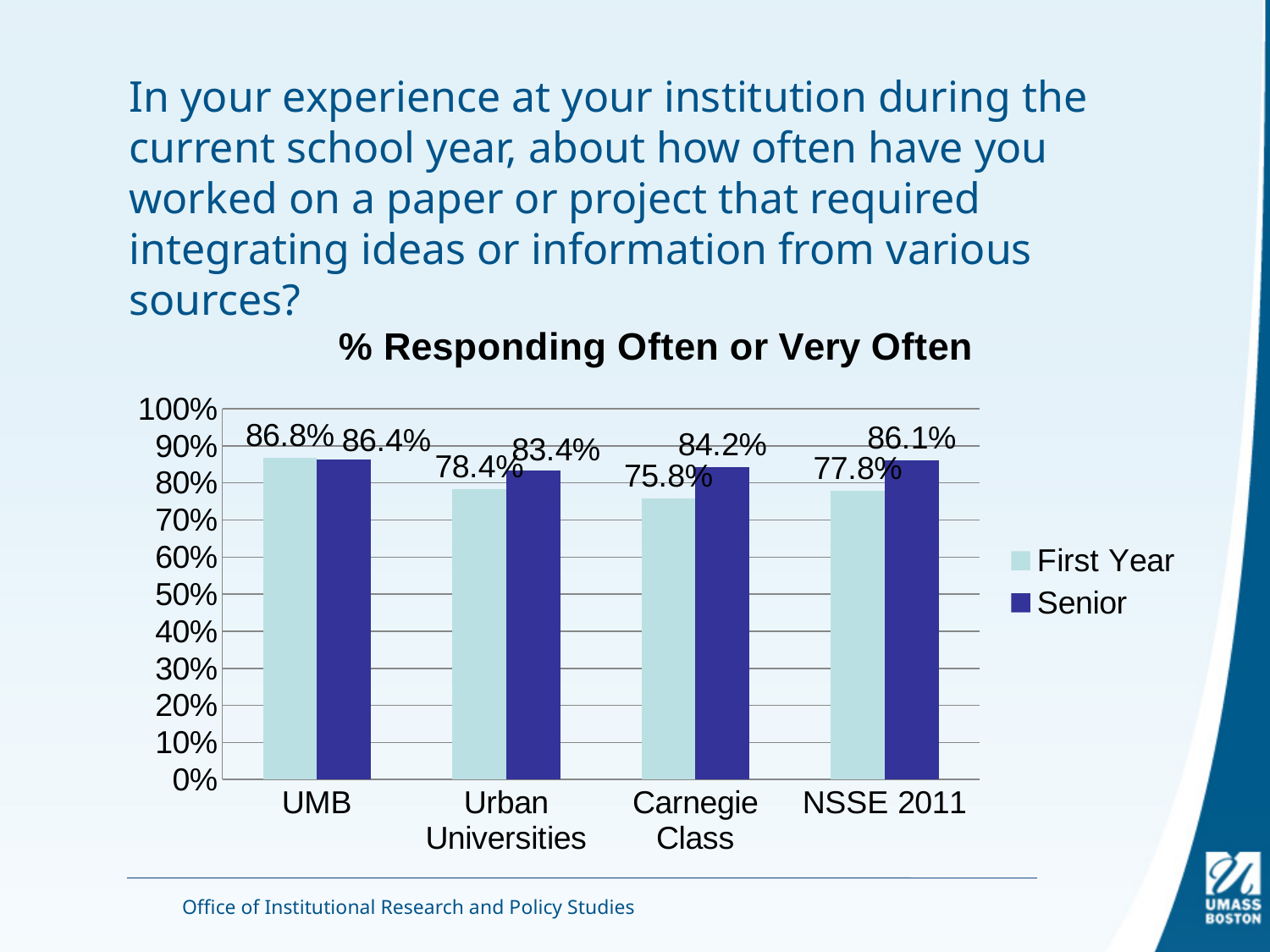
What is the Senior value for Carnegie Class? 84.2% Which is larger, the First Year value for UMB or the First Year value for Urban Universities? UMB Which category has the highest First Year value? UMB Which category has the lowest First Year value? Carnegie Class What is the difference between the Senior and First Year values for Carnegie Class? 8.4% What is the Senior value for Urban Universities? 83.4% Which category has the lowest Senior value? Urban Universities What kind of chart is shown? Bar chart How many categories are shown on the x axis? 4 What is the First Year value for NSSE 2011? 77.8% How many series does the legend list? 2 What is the First Year value for UMB? 86.8%